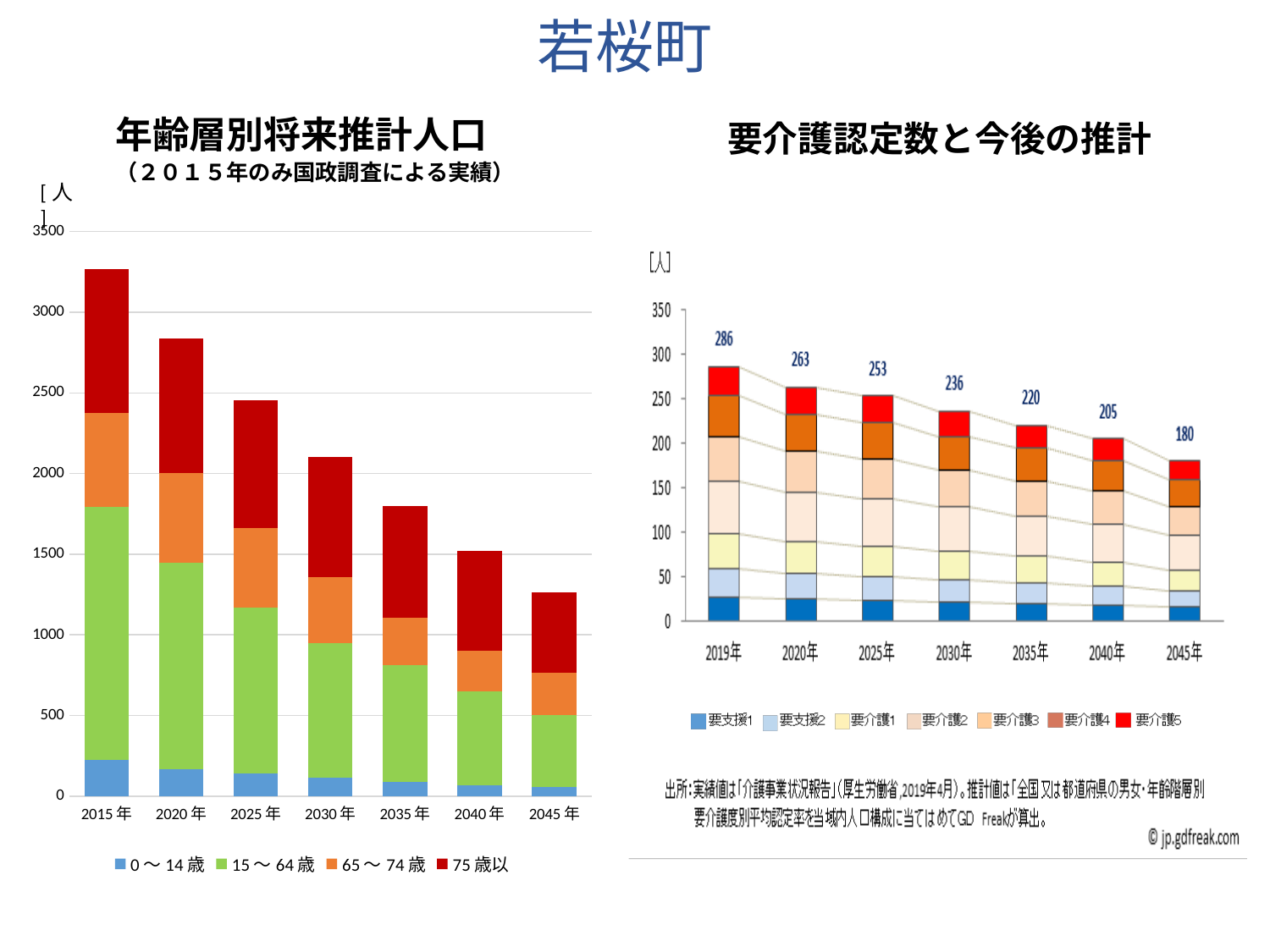
In the left chart (年齢層別将来推計人口), which year has the tallest total bar? 2015年 In the left chart (年齢層別将来推計人口), is the total bar for 2015年 greater or less than 3000? greater In the left chart (年齢層別将来推計人口), how many age groups does the legend list? 4 In the left chart (年齢層別将来推計人口), how many years are shown on the x axis? 7 In the left chart (年齢層別将来推計人口), is the total bar for 2045年 greater or less than 1500? less In the right chart (要介護認定数と今後の推計), what is the difference between the totals for 2019年 and 2045年? 106 In the right chart (要介護認定数と今後の推計), how many series does the legend list? 7 In the right chart (要介護認定数と今後の推計), which is larger, the total for 2020年 or for 2025年? 2020年 In the left chart (年齢層別将来推計人口), do the total bars rise or fall from 2015年 to 2045年? fall In the right chart (要介護認定数と今後の推計), what is the total value for 2019年? 286 In the right chart (要介護認定数と今後の推計), what is the total value for 2045年? 180 What kind of chart is the left chart titled 年齢層別将来推計人口? stacked bar chart